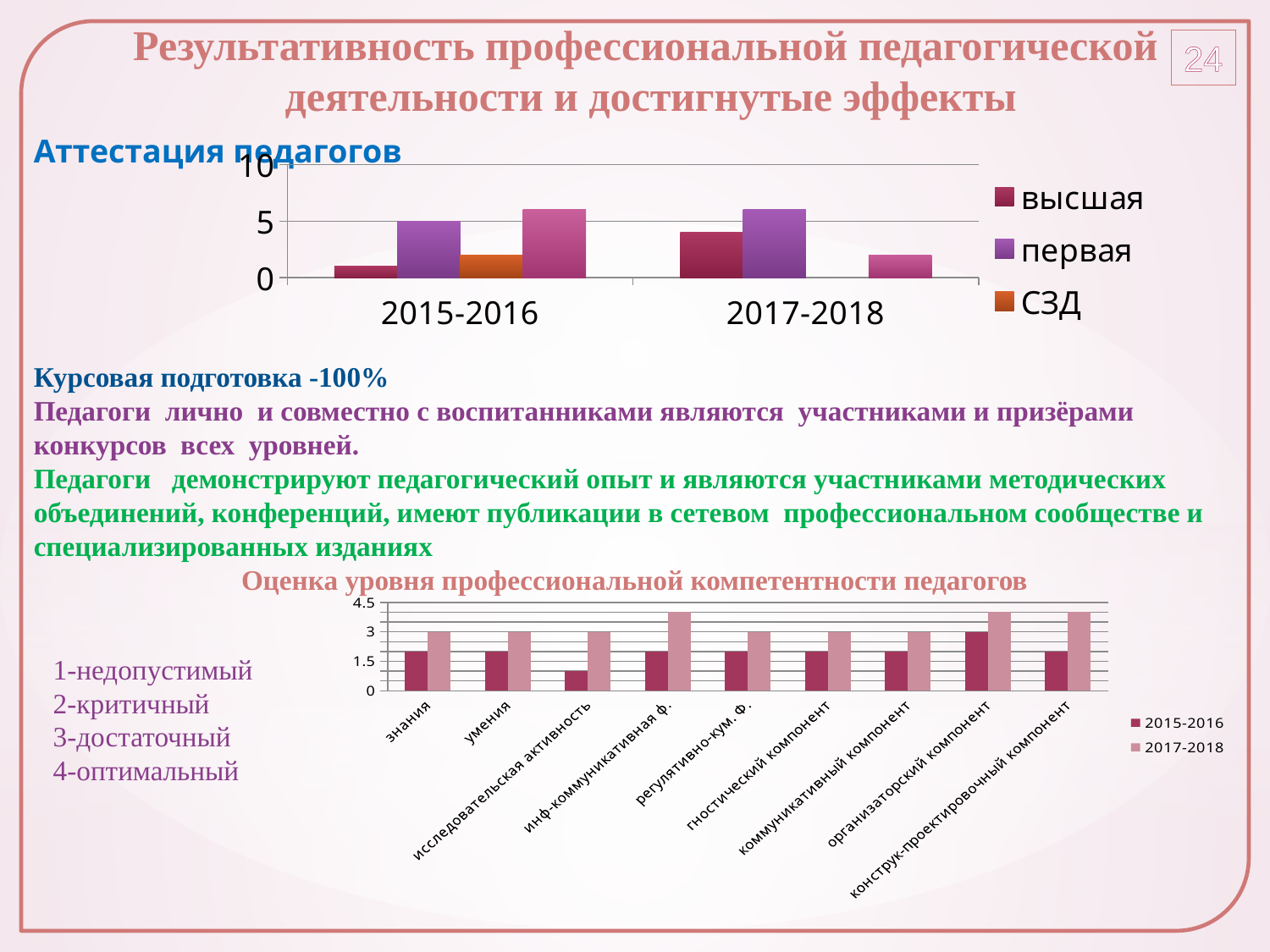
In the 'Оценка уровня профессиональной компетентности педагогов' chart, how many series does the legend list? 2 In the 'Аттестация педагогов' chart, which is larger for 'высшая': 2015-2016 or 2017-2018? 2017-2018 What kind of chart is the 'Аттестация педагогов' chart at the top of the slide? bar chart In the 'Оценка уровня профессиональной компетентности педагогов' chart, how many categories are shown on the x axis? 9 In the 'Аттестация педагогов' chart, is the value for 'высшая' in 2015-2016 greater or less than 5? less In the 'Аттестация педагогов' chart, how many categories are shown on the x axis? 2 In the 'Аттестация педагогов' chart, what is the value for 'первая' in 2015-2016? 5 In the 'Оценка уровня профессиональной компетентности педагогов' chart, is the value for 'инф-коммуникативная ф.' in the 2017-2018 series greater or less than 3? greater In the 'Оценка уровня профессиональной компетентности педагогов' chart, which category has the lowest value in the 2015-2016 series? исследовательская активность In the 'Аттестация педагогов' chart, is the value for 'первая' in 2017-2018 greater or less than 5? greater In the 'Аттестация педагогов' chart, how many series does the legend list? 3 In the 'Оценка уровня профессиональной компетентности педагогов' chart, what is the value for 'организаторский компонент' in the 2015-2016 series? 3